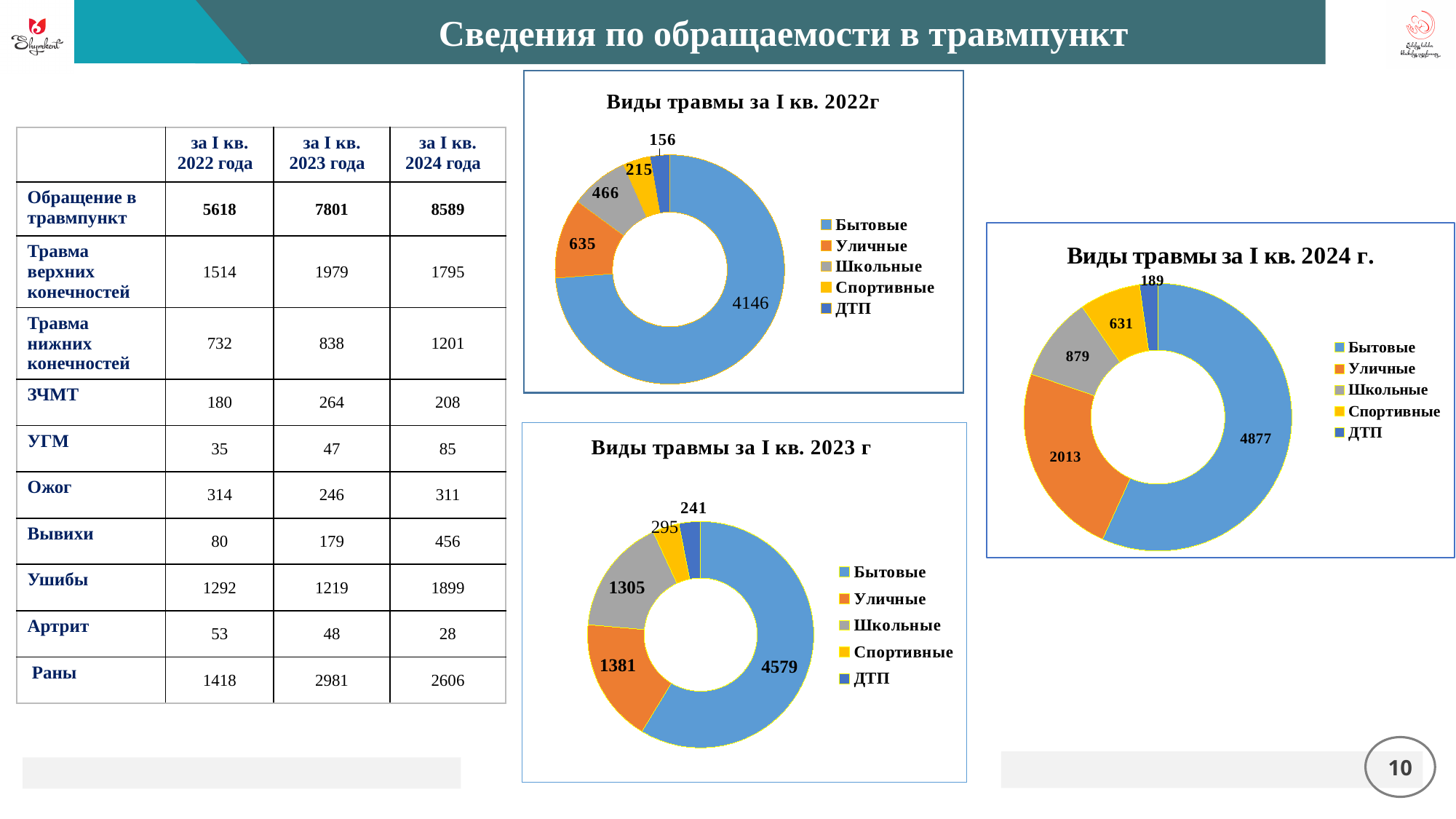
In the chart 'Виды травмы за I кв. 2023 г', what colour represents ДТП? Dark blue In the chart 'Виды травмы за I кв. 2024 г.', what is the value for Спортивные? 631 What type of chart is 'Виды травмы за I кв. 2024 г.'? Doughnut chart In the chart 'Виды травмы за I кв. 2022г', which category has the smallest value? ДТП How many series does the legend of the chart 'Виды травмы за I кв. 2022г' list? 5 In the chart 'Виды травмы за I кв. 2024 г.', which category has the largest value? Бытовые In the chart 'Виды травмы за I кв. 2023 г', which is larger, Уличные or Школьные? Уличные In the chart 'Виды травмы за I кв. 2022г', what is the value for Уличные? 635 How many categories are shown in the chart 'Виды травмы за I кв. 2023 г'? 5 In the chart 'Виды травмы за I кв. 2023 г', what is the value for Школьные? 1305 In the chart 'Виды травмы за I кв. 2024 г.', what is the difference between Уличные and Школьные? 1134 In the chart 'Виды травмы за I кв. 2022г', what is the total of all categories? 5618